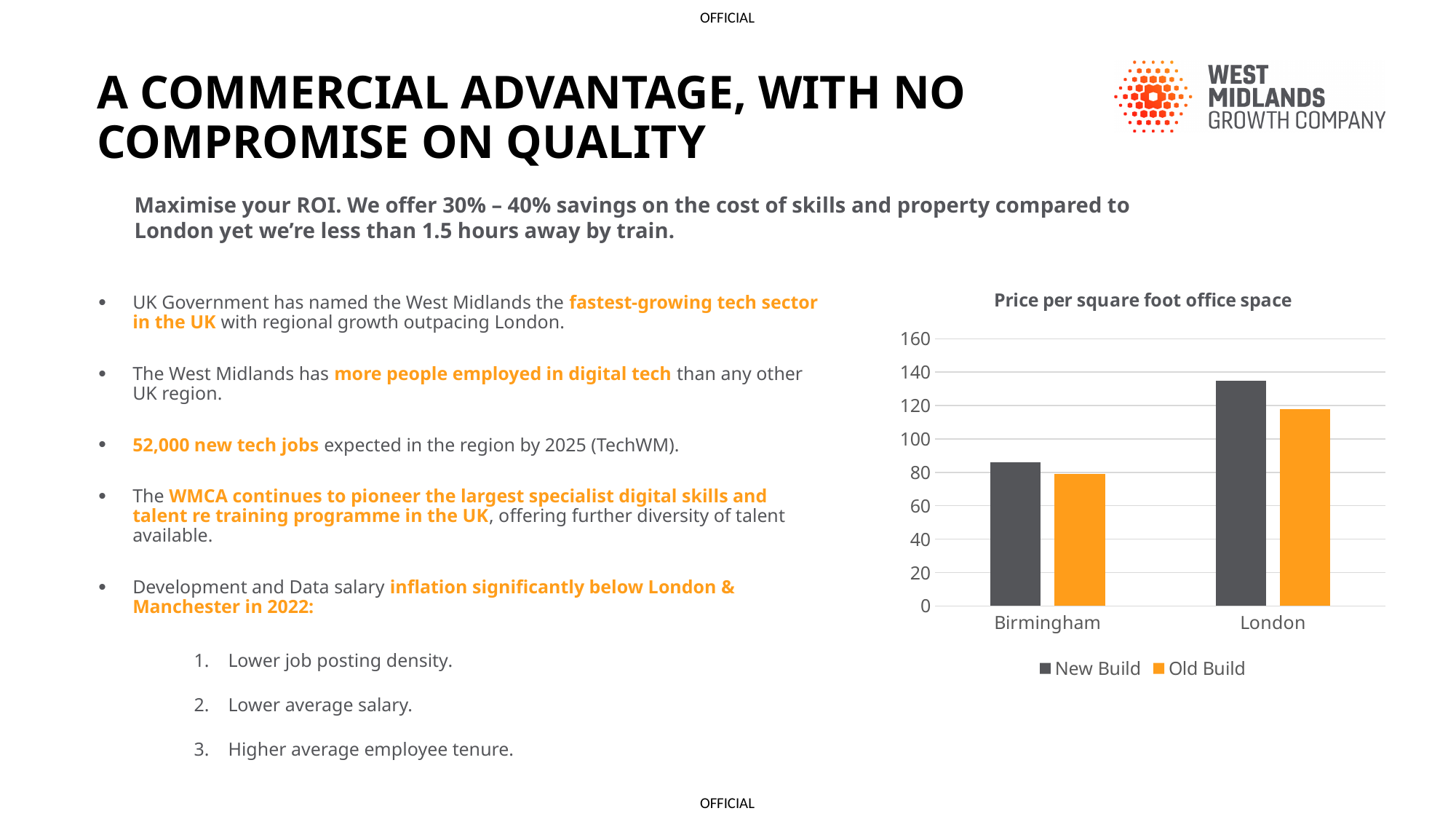
Is the Old Build value for Birmingham greater or less than 60? greater What is the title of the chart on the slide? Price per square foot office space How many categories are shown on the x axis of the chart? 2 Which series is shown in orange in the chart? Old Build Is the New Build value for London greater or less than 120? greater What type of chart is shown on the slide? bar chart How many series does the chart legend list? 2 Is the Old Build value for London greater or less than 100? greater In the chart, which is larger: the Old Build value for London or the New Build value for Birmingham? Old Build value for London Which bar is the lowest in the chart? Birmingham Old Build Which city has the highest New Build price per square foot in the chart? London